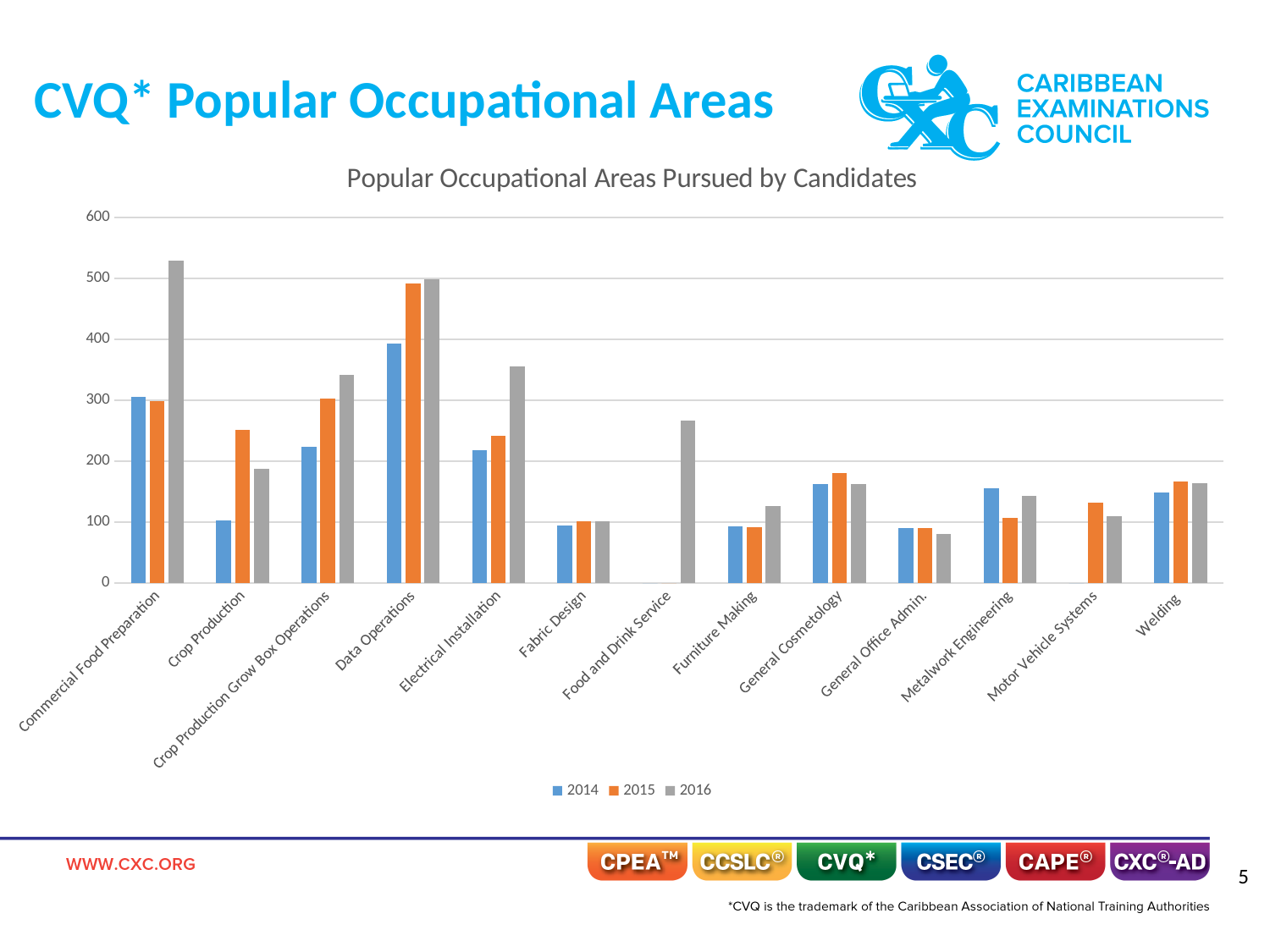
How many series does the legend list? 3 What kind of chart is shown on the slide? bar chart How many occupational areas are shown on the x axis? 13 Which occupational area has the highest 2016 value? Commercial Food Preparation Do the values for Electrical Installation rise or fall from 2014 to 2016? rise For Crop Production, which is larger, the 2015 value or the 2016 value? 2015 Which occupational area has the lowest 2016 value? General Office Admin. For Metalwork Engineering, which is larger, the 2014 value or the 2015 value? 2014 Is the 2016 value for Commercial Food Preparation greater or less than 500? greater Which occupational area has the highest 2014 value? Data Operations Is the 2016 value for Food and Drink Service greater or less than 200? greater